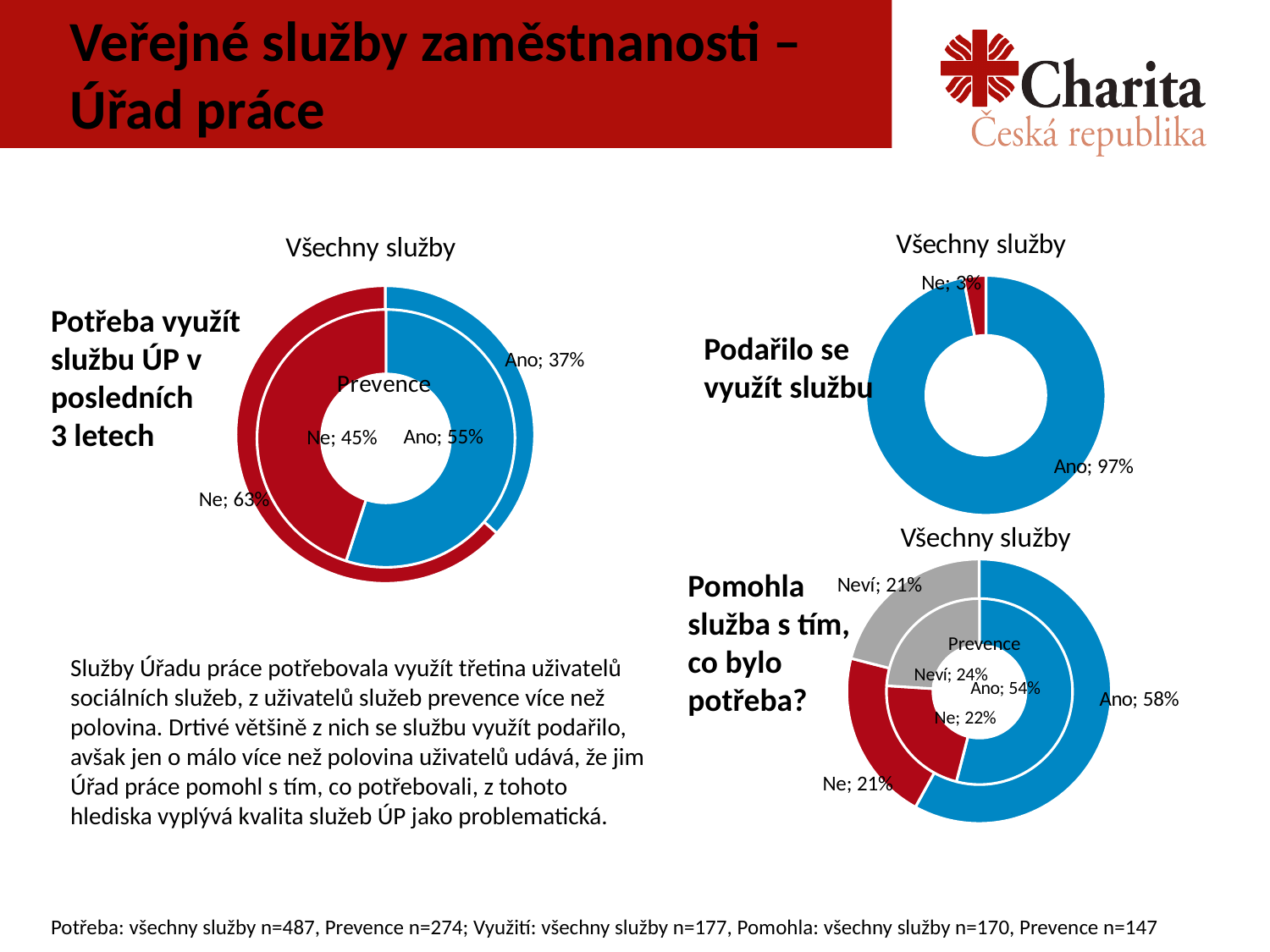
In the chart 'Potřeba využít službu ÚP v posledních 3 letech', what is the value for 'Ano' in the outer ring 'Všechny služby'? 37% What type of chart is used for 'Podařilo se využít službu'? Doughnut (pie) chart In the chart 'Potřeba využít službu ÚP v posledních 3 letech', which is larger in the 'Prevence' ring, 'Ano' or 'Ne'? Ano In the chart 'Potřeba využít službu ÚP v posledních 3 letech', what is the value for 'Ne' in the inner ring 'Prevence'? 45% In the chart 'Pomohla služba s tím, co bylo potřeba?', what is the value for 'Ano' in the inner ring 'Prevence'? 54% In the chart 'Pomohla služba s tím, co bylo potřeba?', what is the value for 'Neví' in the outer ring 'Všechny služby'? 21% In the chart 'Podařilo se využít službu', which category is the smallest? Ne In the chart 'Potřeba využít službu ÚP v posledních 3 letech', what is the difference between 'Ne' and 'Ano' in the 'Všechny služby' ring? 26 percentage points How many categories are shown in the 'Prevence' ring of the chart 'Pomohla služba s tím, co bylo potřeba?'? 3 In the chart 'Podařilo se využít službu', what is the value for 'Ano'? 97% In the chart 'Pomohla služba s tím, co bylo potřeba?', which category is the largest in the 'Všechny služby' ring? Ano In the chart 'Podařilo se využít službu', what is the value for 'Ne'? 3%